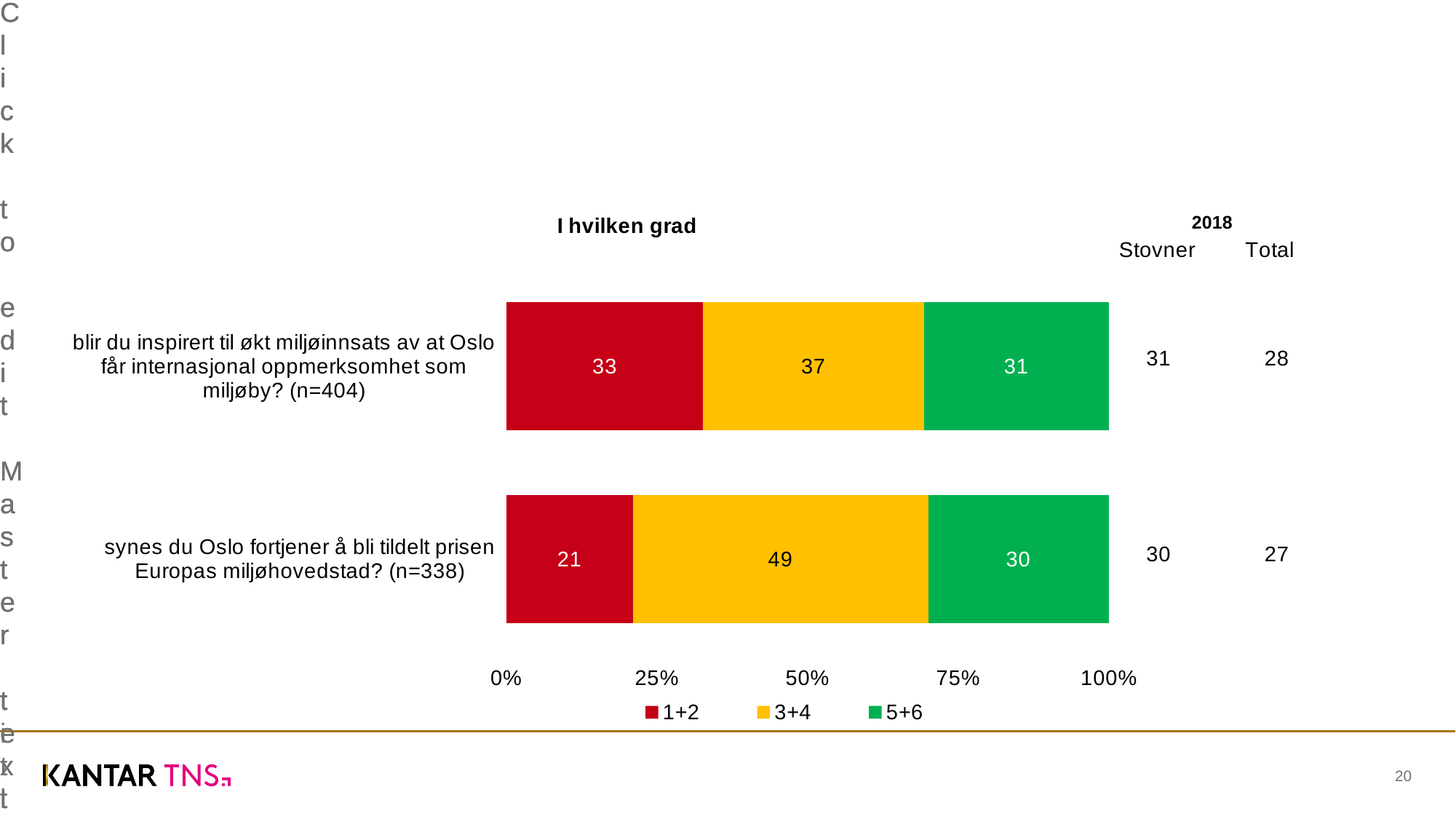
What kind of chart is shown on the slide? Stacked bar chart Which question has the larger 1+2 value? blir du inspirert til økt miljøinnsats av at Oslo får internasjonal oppmerksomhet som miljøby? How many series does the legend list? 3 What is the value of the 1+2 series for the question "synes du Oslo fortjener å bli tildelt prisen Europas miljøhovedstad?"? 21 How many questions (categories) are plotted in the chart? 2 What is the difference between the 3+4 values of the two questions? 12 What is the value of the 5+6 series for the question "blir du inspirert til økt miljøinnsats av at Oslo får internasjonal oppmerksomhet som miljøby?"? 31 Which series has the largest value for the question "synes du Oslo fortjener å bli tildelt prisen Europas miljøhovedstad?"? 3+4 What is the value of the 1+2 series for the question "blir du inspirert til økt miljøinnsats av at Oslo får internasjonal oppmerksomhet som miljøby?"? 33 Which series has the smallest value for the question "synes du Oslo fortjener å bli tildelt prisen Europas miljøhovedstad?"? 1+2 What is the title of the chart? I hvilken grad What is the value of the 3+4 series for the question "synes du Oslo fortjener å bli tildelt prisen Europas miljøhovedstad?"? 49